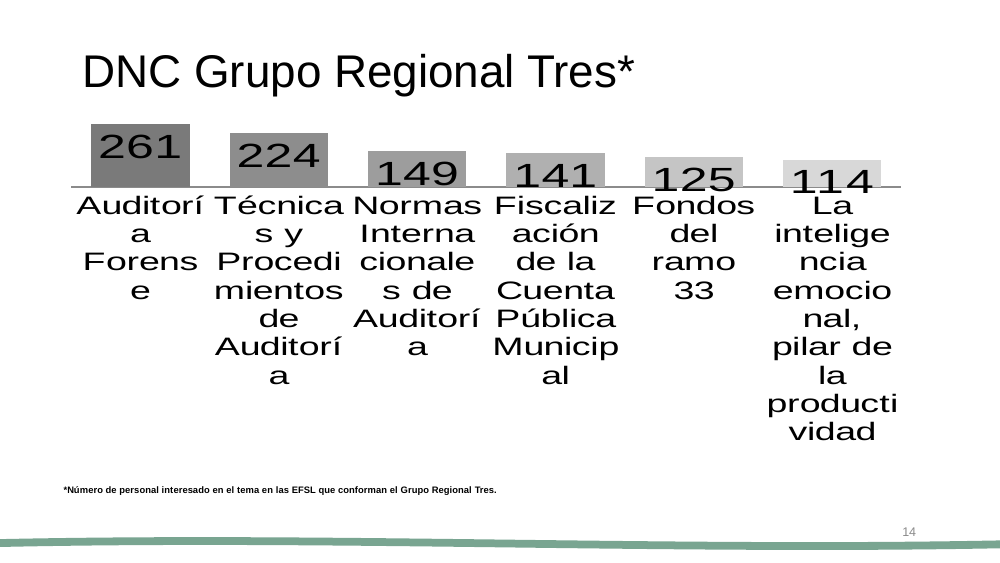
Which category has the lowest value? La inteligencia emocional, pilar de la productividad What is the value for Auditoría Forense? 261 Which is larger, the value for Fondos del ramo 33 or the value for Fiscalización de la Cuenta Pública Municipal? Fiscalización de la Cuenta Pública Municipal How many categories are shown in the chart? 6 What is the value for Fondos del ramo 33? 125 What is the difference between the values for Auditoría Forense and Técnicas y Procedimientos de Auditoría? 37 What kind of chart is shown on the slide? Bar chart What is the value for Técnicas y Procedimientos de Auditoría? 224 Do the values rise or fall from left to right across the categories? Fall Which category has the highest value? Auditoría Forense What is the value for La inteligencia emocional, pilar de la productividad? 114 What is the difference between the values for Normas Internacionales de Auditoría and Fiscalización de la Cuenta Pública Municipal? 8